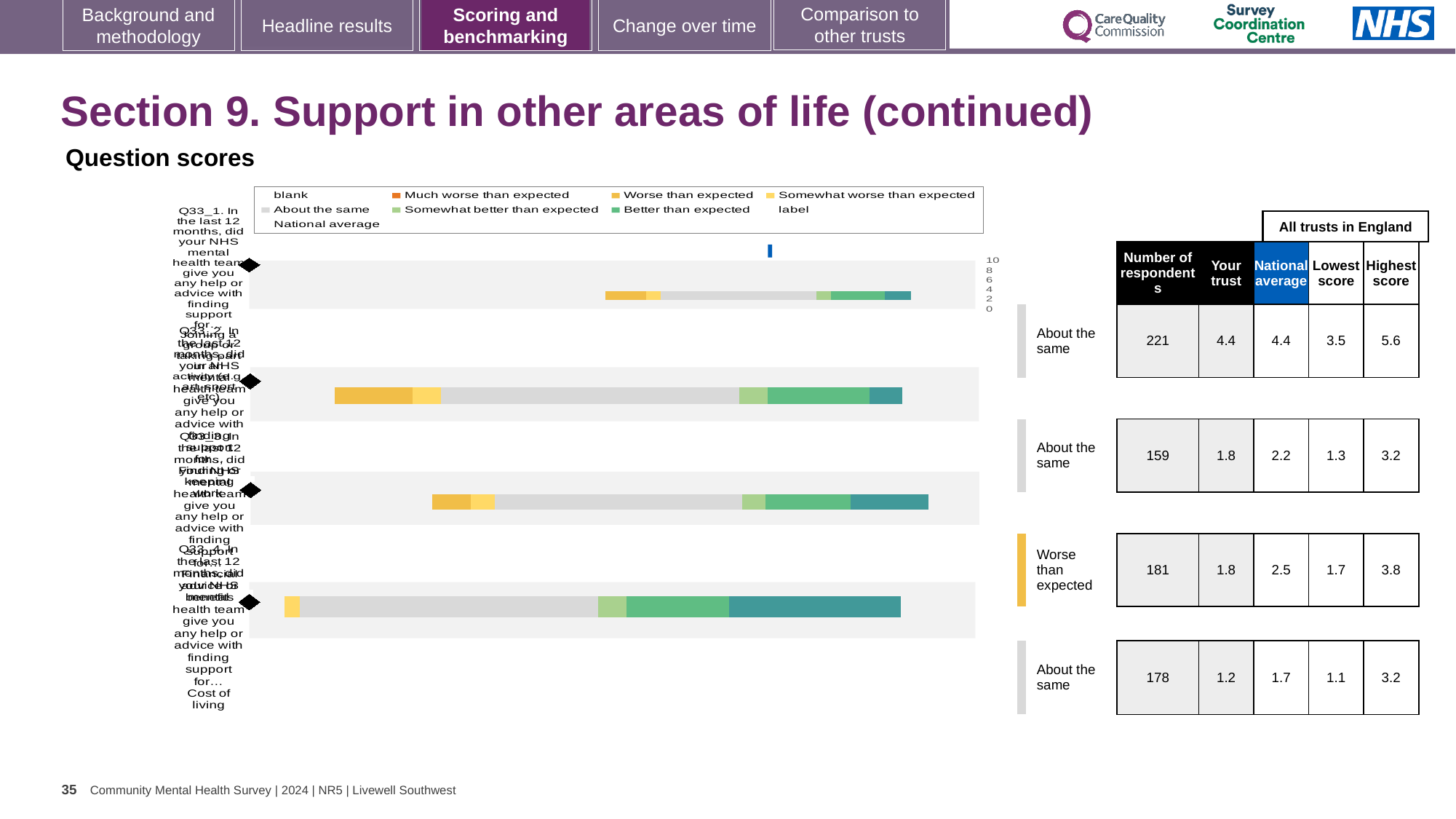
In the table beside the chart, what is the 'Your trust' score for the first question (Q33_1)? 4.4 In the table beside the chart, what is the number of respondents for the first question (Q33_1)? 221 Is the 'Your trust' score for the first question (Q33_1) larger or smaller than the lowest score for that question? larger Which legend entry is shown in dark orange in the chart legend? Much worse than expected Which question has the lowest number of respondents in the table beside the chart? Q33_2 How many question bars are plotted in the chart? 4 In the table beside the chart, what is the highest score for the last question (Q33_4, cost of living)? 3.2 What is the difference between the national average and the 'Your trust' score for the third question (Q33_3)? 0.7 Which benchmark label is shown for the third question (Q33_3)? Worse than expected What kind of chart is shown under 'Question scores'? bar chart In the table beside the chart, what is the national average for the third question (Q33_3)? 2.5 Which question has the highest 'Your trust' score in the table beside the chart? Q33_1